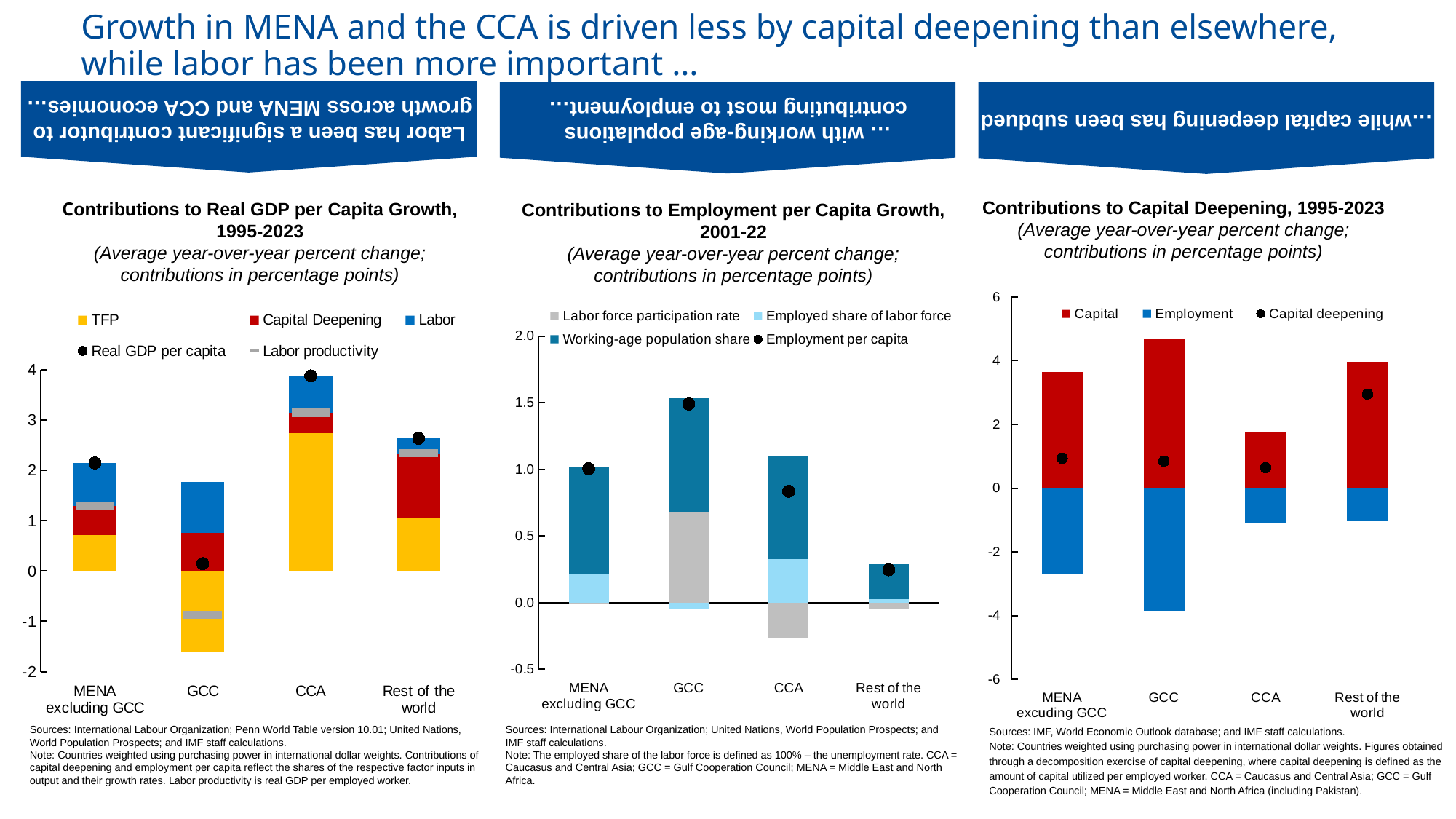
What kind of chart is the chart titled 'Contributions to Capital Deepening, 1995-2023'? Stacked bar chart In the chart titled 'Contributions to Real GDP per Capita Growth, 1995-2023', which category has the lowest Real GDP per capita marker? GCC In the chart titled 'Contributions to Capital Deepening, 1995-2023', which category has the largest Capital contribution bar? GCC In the chart titled 'Contributions to Real GDP per Capita Growth, 1995-2023', how many entries does the legend list? 5 In the chart titled 'Contributions to Real GDP per Capita Growth, 1995-2023', is the Real GDP per capita value for CCA greater or less than 3? greater In the chart titled 'Contributions to Employment per Capita Growth, 2001-22', which category has the lowest Employment per capita marker? Rest of the world In the chart titled 'Contributions to Capital Deepening, 1995-2023', which category has the highest Capital deepening marker? Rest of the world In the chart titled 'Contributions to Real GDP per Capita Growth, 1995-2023', which category has the highest Real GDP per capita marker? CCA In the chart titled 'Contributions to Employment per Capita Growth, 2001-22', how many categories are shown on the x axis? 4 In the chart titled 'Contributions to Capital Deepening, 1995-2023', is the Capital deepening value for Rest of the world greater or less than 2? greater In the chart titled 'Contributions to Employment per Capita Growth, 2001-22', is the Employment per capita value for GCC greater or less than 1.0? greater